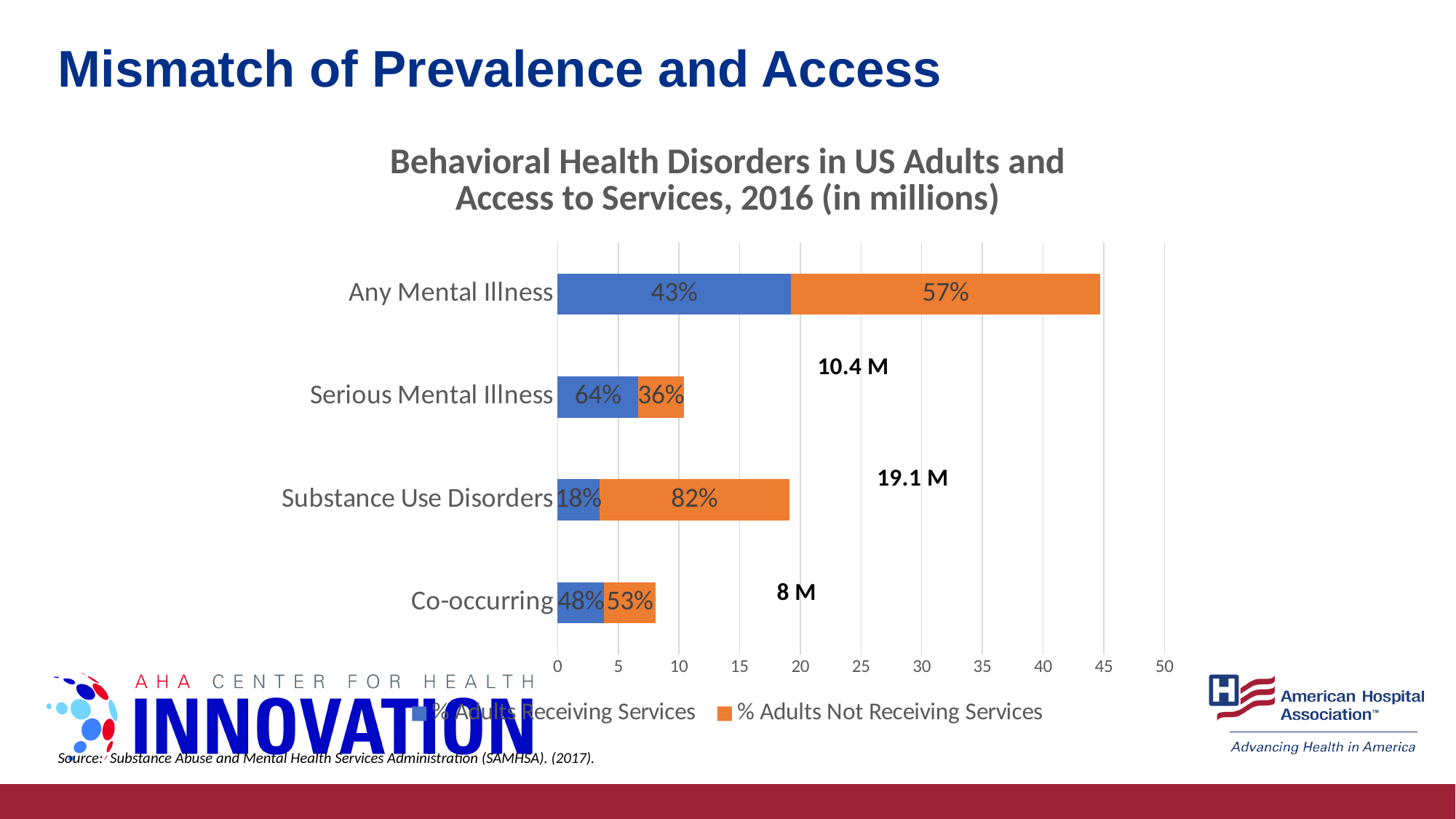
How many series does the legend list? 2 What percentage of adults with Serious Mental Illness are receiving services? 64% What percentage of adults with Any Mental Illness are not receiving services? 57% What percentage of adults with Substance Use Disorders are not receiving services? 82% How many categories are shown on the chart? 4 What percentage of adults with Co-occurring disorders are receiving services? 48% Which category has the longest total bar? Any Mental Illness What kind of chart is shown on the slide? Stacked bar chart Is the total bar length for Any Mental Illness greater or less than 40? greater Which category has a higher percentage of adults receiving services, Serious Mental Illness or Substance Use Disorders? Serious Mental Illness What percentage of adults with Any Mental Illness are receiving services? 43% Which category has the shortest total bar? Co-occurring